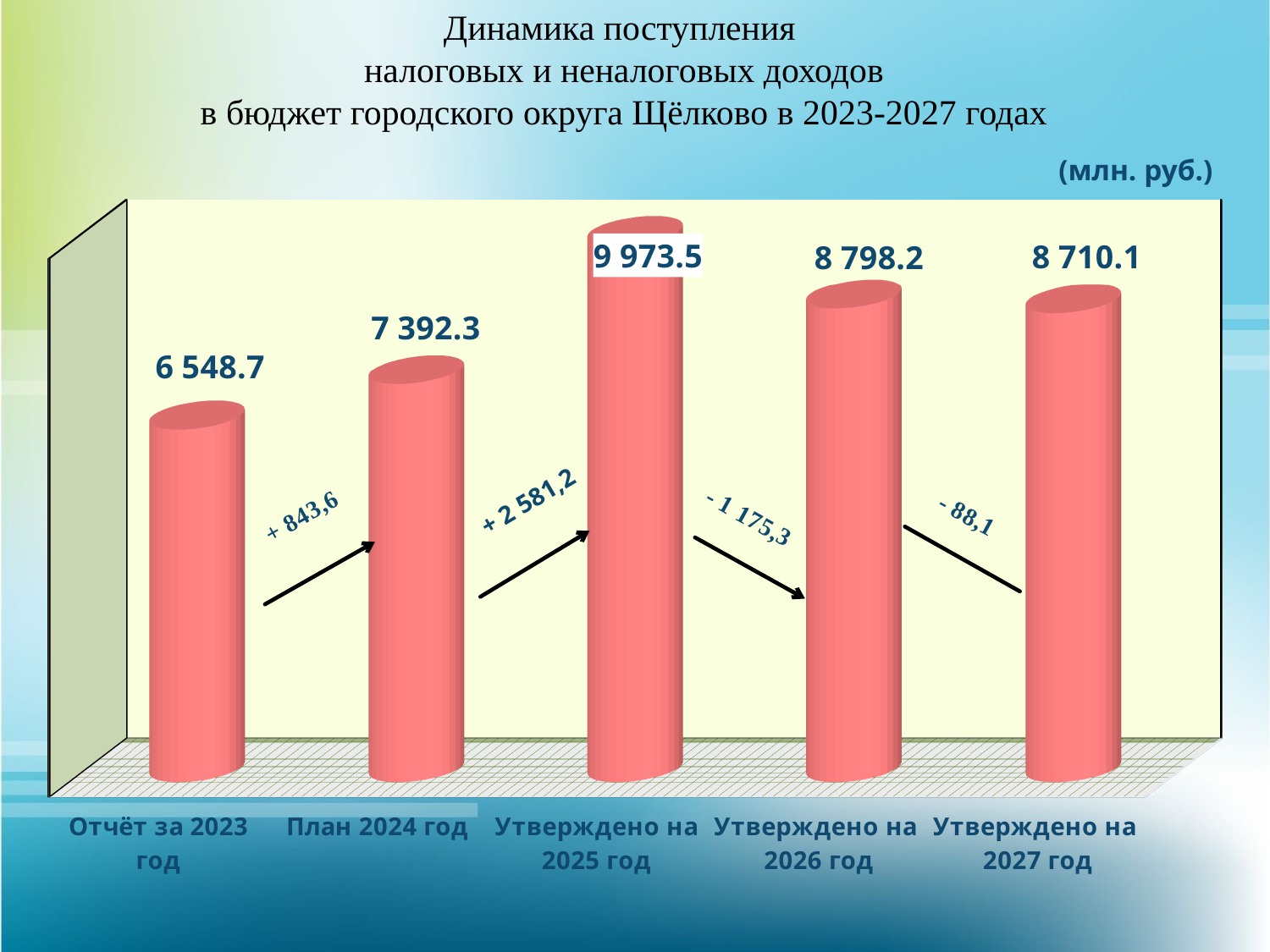
What is the value for «Отчёт за 2023 год»? 6 548.7 What is the value for «План 2024 год»? 7 392.3 Which category has the highest value? Утверждено на 2025 год What is the difference between the values for «План 2024 год» and «Отчёт за 2023 год»? 843.6 What kind of chart is shown on the slide? Bar chart Which category has the lowest value? Отчёт за 2023 год What is the difference between the values for «Утверждено на 2025 год» and «Утверждено на 2026 год»? 1 175.3 How many categories are shown on the chart? 5 What is the value for «Утверждено на 2025 год»? 9 973.5 Do the values rise or fall from «Утверждено на 2025 год» to «Утверждено на 2027 год»? Fall What is the value for «Утверждено на 2027 год»? 8 710.1 Which is larger: the value for «Утверждено на 2026 год» or «Утверждено на 2027 год»? Утверждено на 2026 год